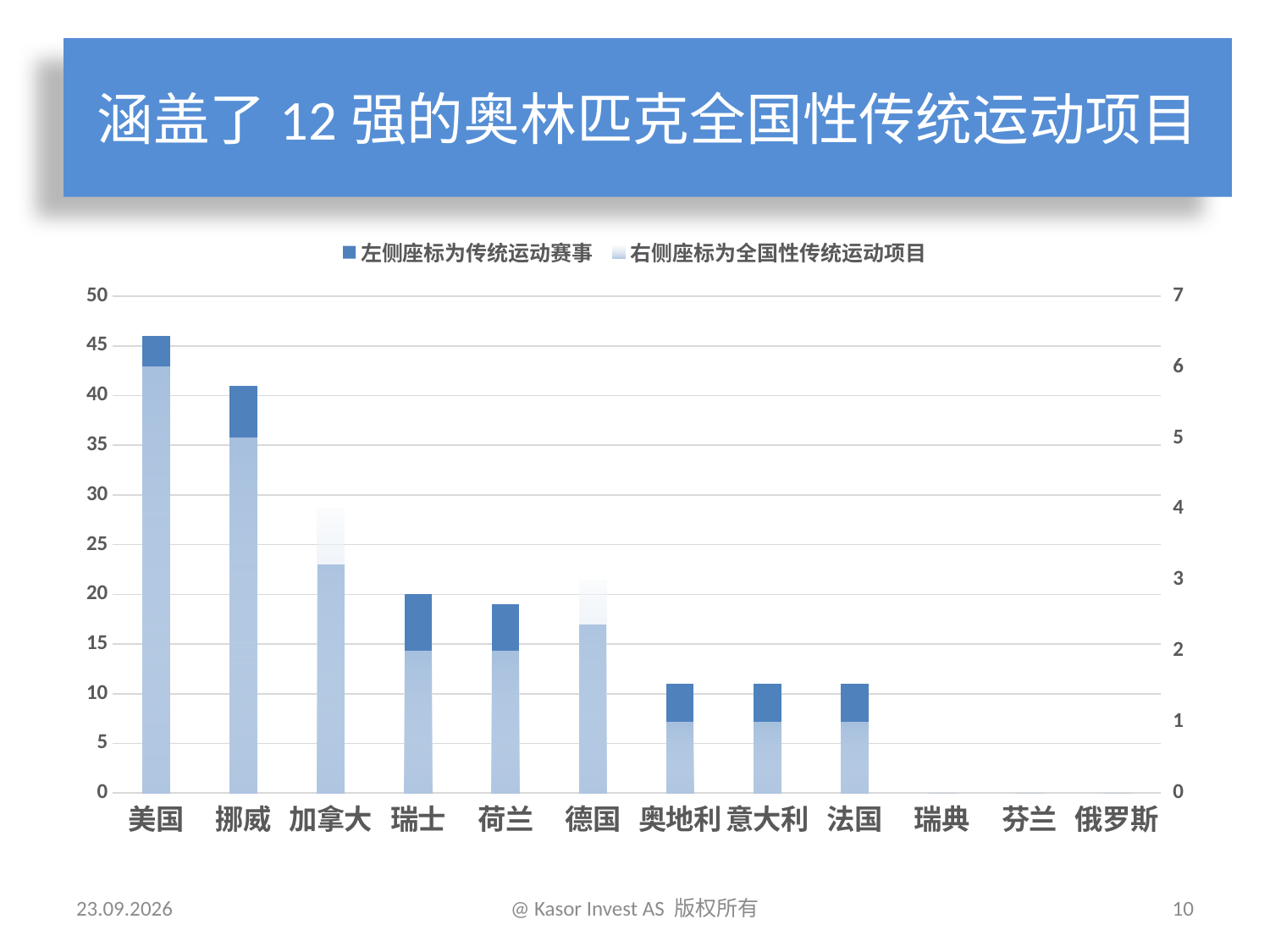
Is the 左侧座标为传统运动赛事 value for 挪威 greater or less than 35? greater Which country has the larger 左侧座标为传统运动赛事 bar, 美国 or 挪威? 美国 How many countries are listed along the x axis of the chart? 12 Which country has the larger 左侧座标为传统运动赛事 bar, 挪威 or 瑞士? 挪威 What kind of chart is shown on the slide? bar chart How many countries on the x axis have no bars at all? 3 On the right axis, what is the 右侧座标为全国性传统运动项目 value for 美国? 6 Is the 左侧座标为传统运动赛事 value for 瑞士 greater or less than 25? less On the right axis, what is the 右侧座标为全国性传统运动项目 value for 加拿大? 4 Which country has the highest bar for 左侧座标为传统运动赛事? 美国 How many series does the chart legend list? 2 Is the 左侧座标为传统运动赛事 value for 荷兰 greater or less than 15? greater